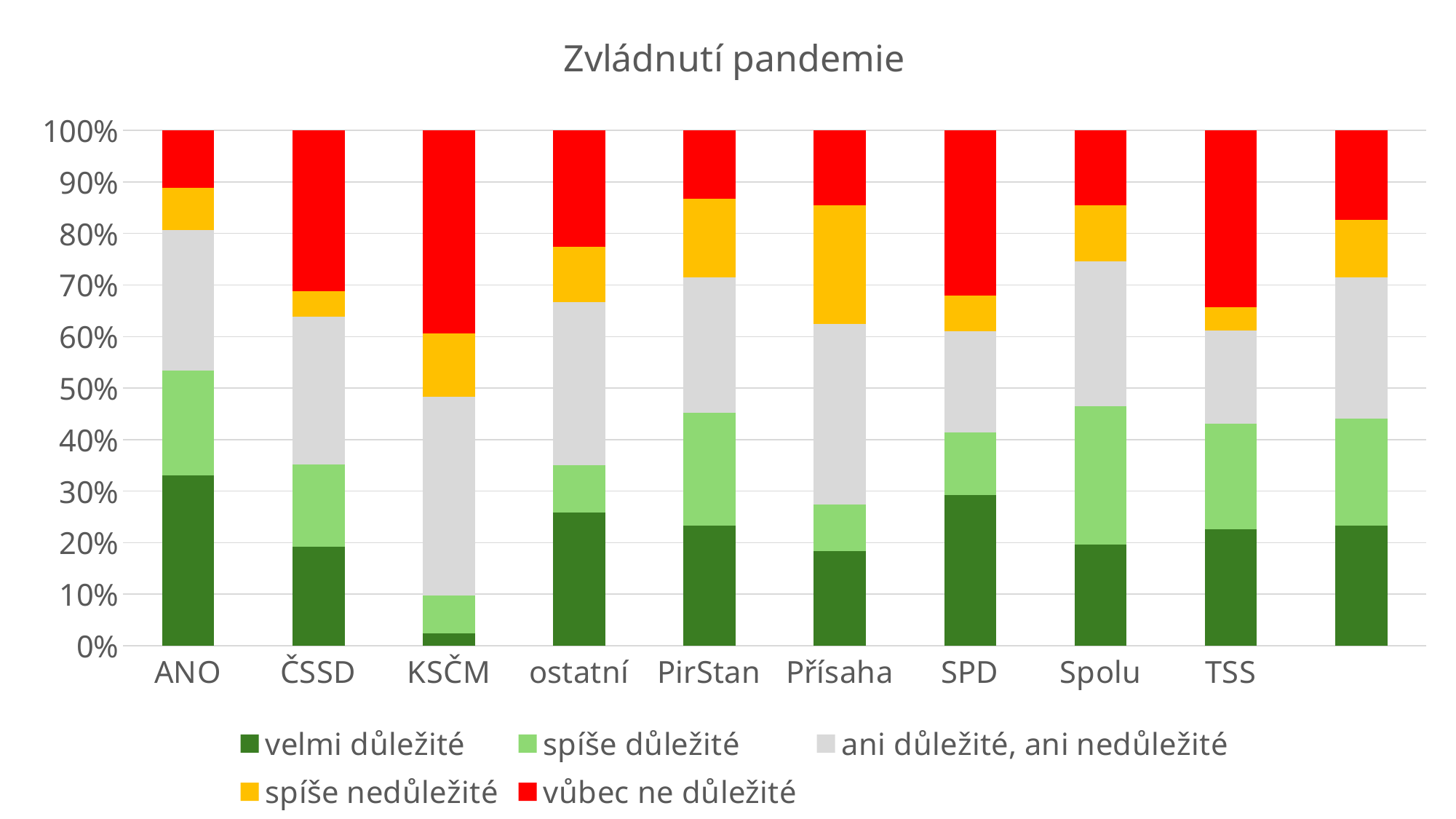
Which category has the smallest 'velmi důležité' segment? KSČM What is the total height of the stacked bar for ANO? 100% How many categories are shown on the x axis of the chart? 9 Which has a larger 'velmi důležité' segment, SPD or Přísaha? SPD Which category has the largest 'vůbec ne důležité' segment? KSČM What is the title of the chart? Zvládnutí pandemie Which category has the largest 'velmi důležité' segment? ANO Is the 'velmi důležité' value for KSČM greater or less than 10%? less How many series does the legend list? 5 What kind of chart is shown on the slide? stacked bar chart Which has a larger 'velmi důležité' segment, ANO or ČSSD? ANO Is the 'velmi důležité' value for ANO greater or less than 30%? greater